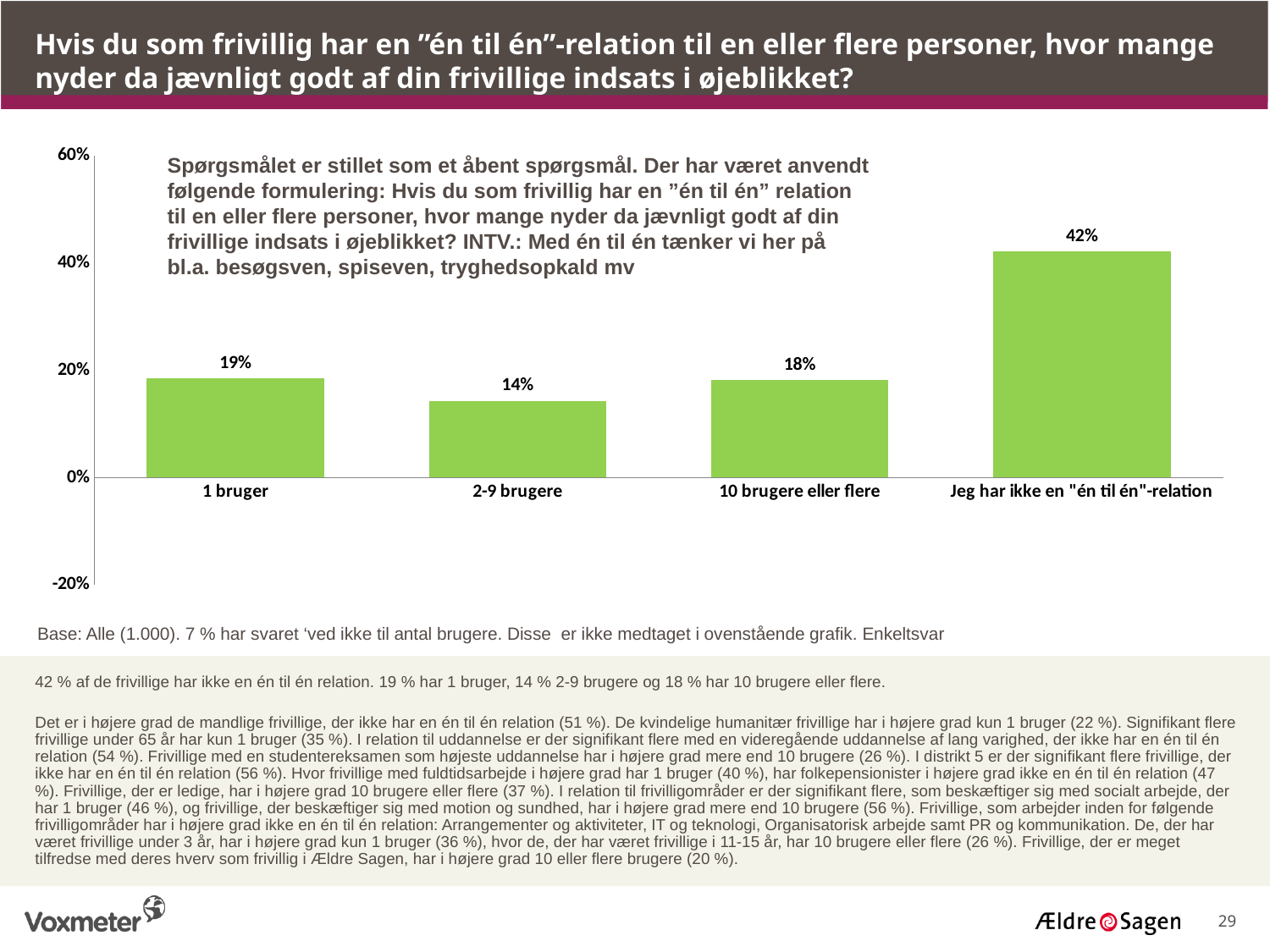
What is the difference between the values for "Jeg har ikke en "én til én"-relation" and "1 bruger"? 23% What is the value for "Jeg har ikke en "én til én"-relation"? 42% What is the value for "2-9 brugere"? 14% Which category has the highest value? Jeg har ikke en "én til én"-relation What is the value for "10 brugere eller flere"? 18% What is the value for "1 bruger"? 19% Is the value for "Jeg har ikke en "én til én"-relation" greater or less than 40%? greater Which category has the lowest value? 2-9 brugere How many categories are shown on the x axis? 4 What kind of chart is shown on the slide? Bar chart Which is larger, the value for "1 bruger" or the value for "10 brugere eller flere"? 1 bruger What is the difference between the values for "1 bruger" and "2-9 brugere"? 5%